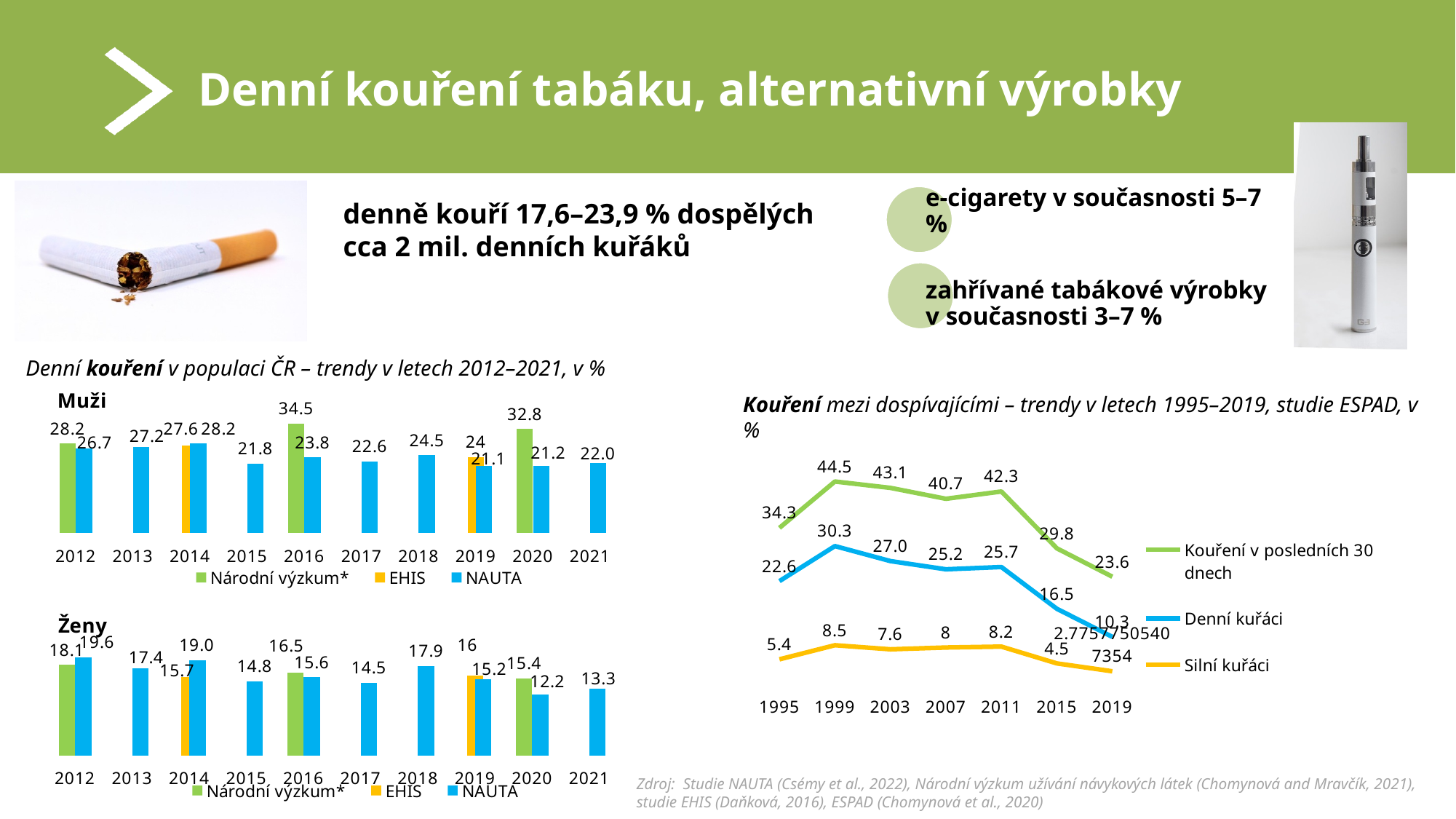
In the Muži chart, what is the difference between the NAUTA values for 2014 and 2021? 6.2 In the Muži chart, how many series does the legend list? 3 In the ESPAD chart (Kouření mezi dospívajícími), what is the value of Kouření v posledních 30 dnech in 1999? 44.5 In the Muži chart, what is the NAUTA value for 2016? 23.8 What kind of chart is the ESPAD chart (Kouření mezi dospívajícími)? line chart In the Ženy chart, is the NAUTA value larger in 2012 or in 2013? 2012 In the ESPAD chart (Kouření mezi dospívajícími), does the Kouření v posledních 30 dnech series rise or fall from 2011 to 2019? fall In the Muži chart, which year has the highest Národní výzkum value? 2016 In the ESPAD chart (Kouření mezi dospívajícími), what is the value of Denní kuřáci in 2019? 10.3 In the Ženy chart, which year has the lowest NAUTA value? 2020 In the ESPAD chart (Kouření mezi dospívajícími), how many years are shown on the x axis? 7 In the Ženy chart, what is the NAUTA value for 2020? 12.2